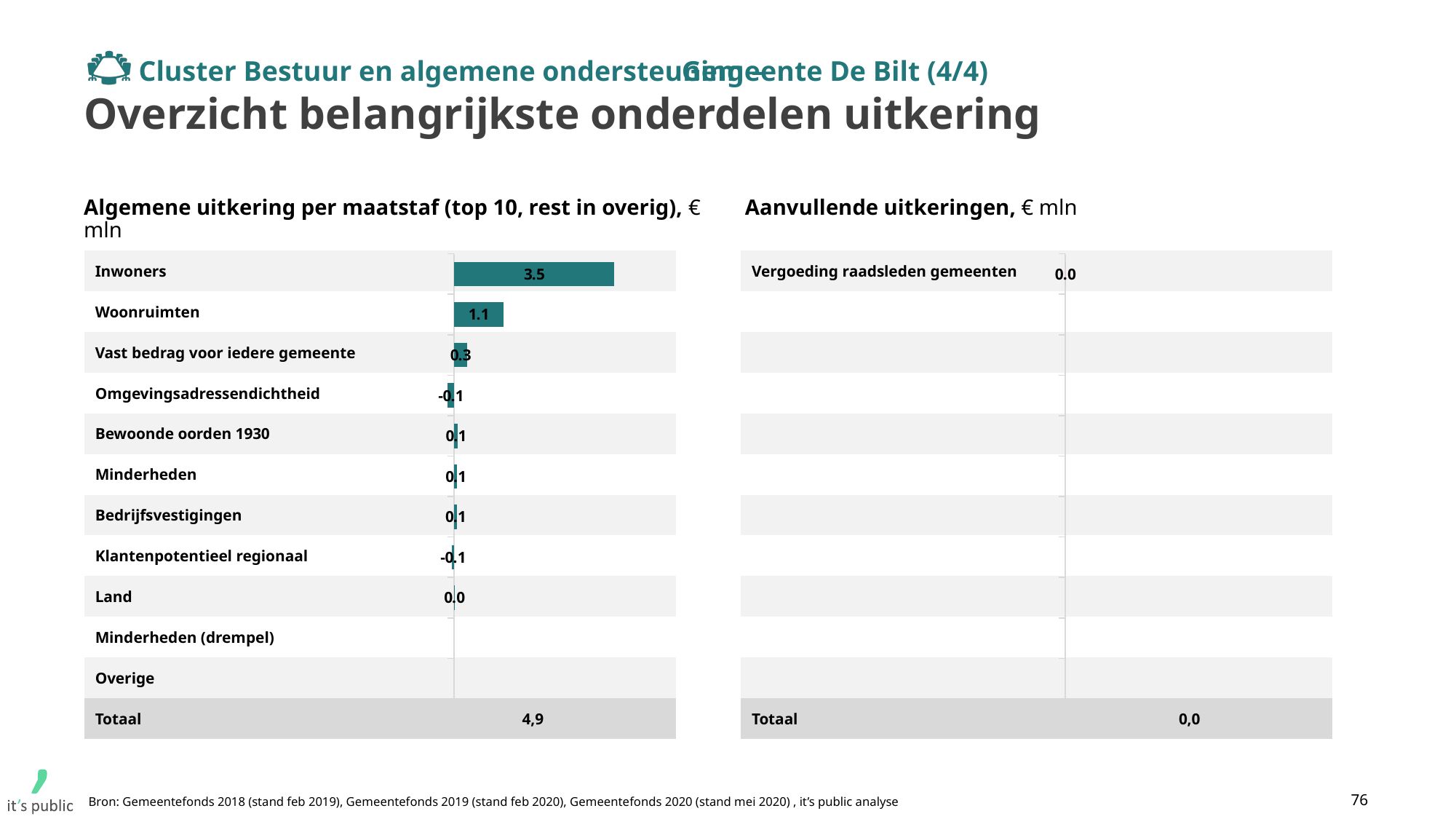
In the left chart 'Algemene uitkering per maatstaf', what is the difference between the values for Inwoners and Woonruimten? 2.4 In the left chart 'Algemene uitkering per maatstaf', what is the value for Omgevingsadressendichtheid? -0.1 What unit is stated in the title of the right chart 'Aanvullende uitkeringen'? € mln In the left chart 'Algemene uitkering per maatstaf', what is the value for Vast bedrag voor iedere gemeente? 0.3 In the left chart 'Algemene uitkering per maatstaf', which is larger: the value for Woonruimten or the value for Vast bedrag voor iedere gemeente? Woonruimten In the left chart 'Algemene uitkering per maatstaf', what is the value for Inwoners? 3.5 In the left chart 'Algemene uitkering per maatstaf', what is the value for Woonruimten? 1.1 How many categories (excluding Totaal) are listed in the left chart 'Algemene uitkering per maatstaf'? 11 What kind of chart is the left chart 'Algemene uitkering per maatstaf'? Bar chart In the left chart 'Algemene uitkering per maatstaf', what is the Totaal value shown? 4,9 In the right chart 'Aanvullende uitkeringen', what is the value for Vergoeding raadsleden gemeenten? 0.0 In the left chart 'Algemene uitkering per maatstaf', which category has the highest value? Inwoners